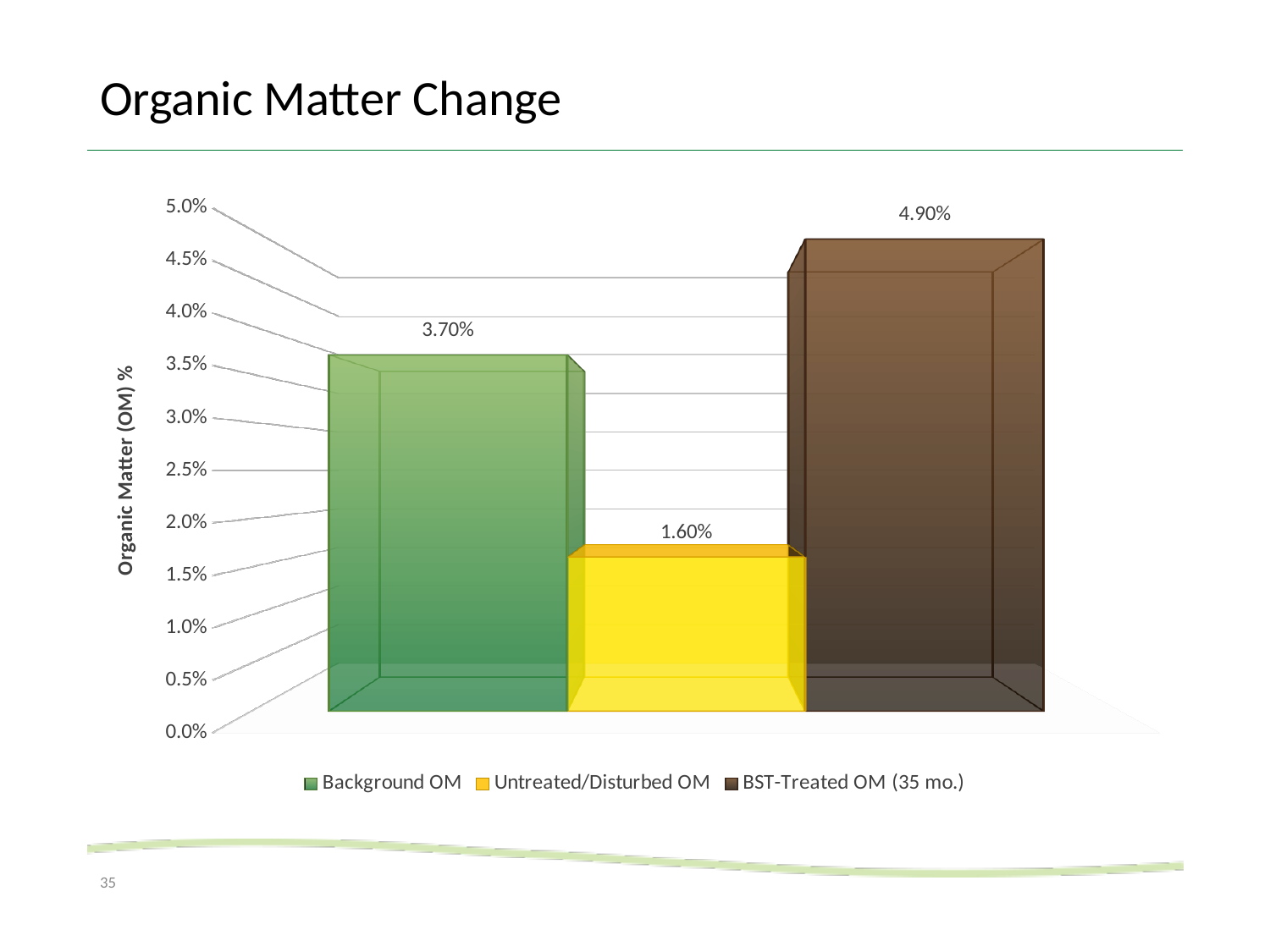
Which is larger, Background OM or Untreated/Disturbed OM? Background OM What is the difference between the Background OM value and the Untreated/Disturbed OM value? 2.10% What is the value for Untreated/Disturbed OM? 1.60% How many series does the legend list? 3 Which series has the lowest value? Untreated/Disturbed OM What is the difference between the BST-Treated OM (35 mo.) value and the Background OM value? 1.20% Which series has the highest value? BST-Treated OM (35 mo.) What kind of chart is shown on the slide? bar chart Is the value for Untreated/Disturbed OM greater or less than 2.0%? less What is the label of the vertical axis? Organic Matter (OM) % What is the value for Background OM? 3.70% What is the value for BST-Treated OM (35 mo.)? 4.90%